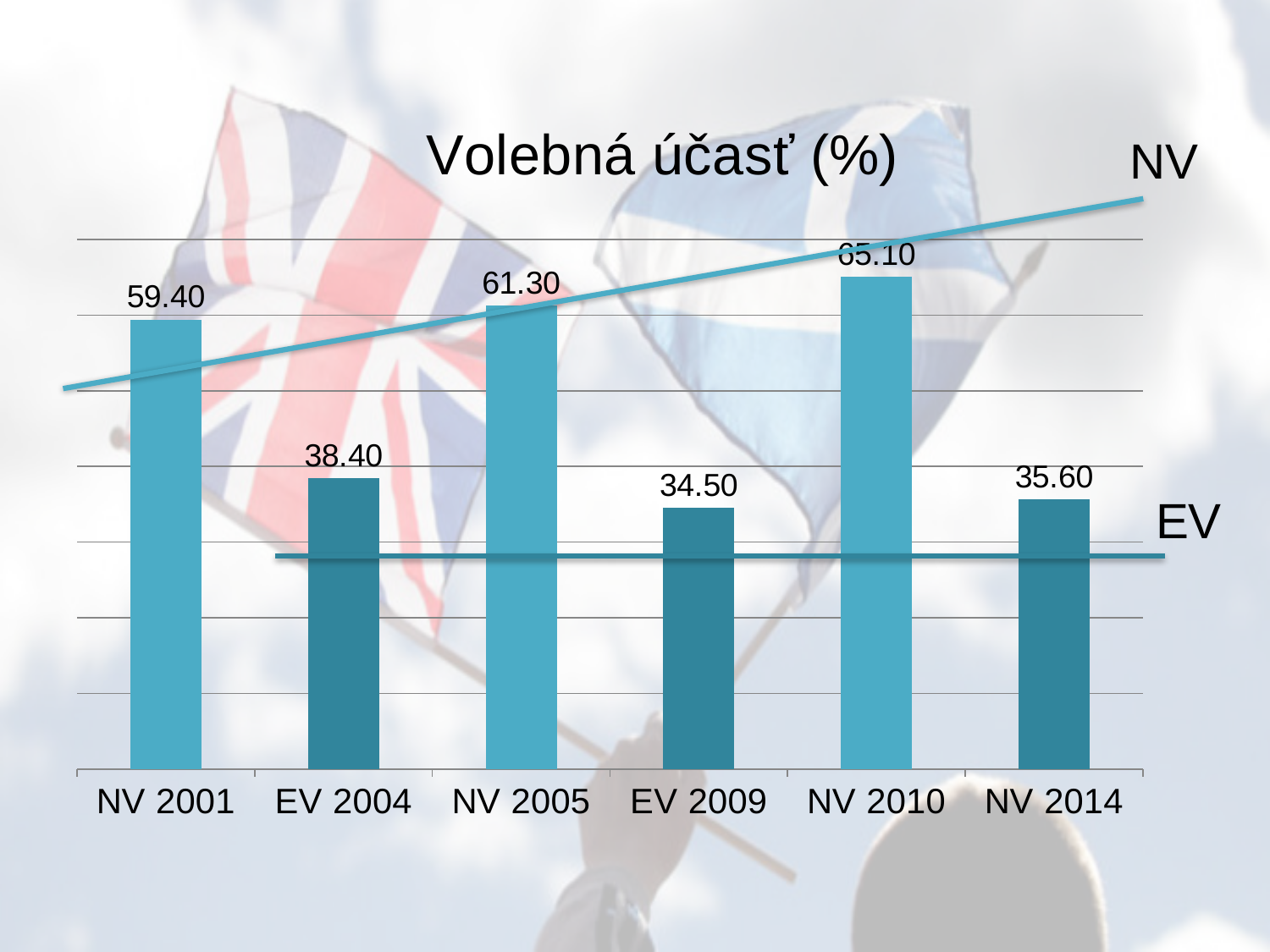
What is the difference between the turnout for NV 2010 and NV 2005? 3.80 Which category has the lowest voter turnout? EV 2009 What kind of chart is shown on the slide? Bar chart What is the voter turnout value shown for EV 2004? 38.40 What is the difference between the turnout for EV 2004 and EV 2009? 3.90 How many categories are shown on the x axis of the chart? 6 Which is larger, the turnout for NV 2001 or NV 2005? NV 2005 What is the title of the chart? Volebná účasť (%) What is the voter turnout value shown for NV 2010? 65.10 What is the voter turnout value shown for NV 2001? 59.40 Which category has the highest voter turnout? NV 2010 What is the voter turnout value shown for EV 2009? 34.50